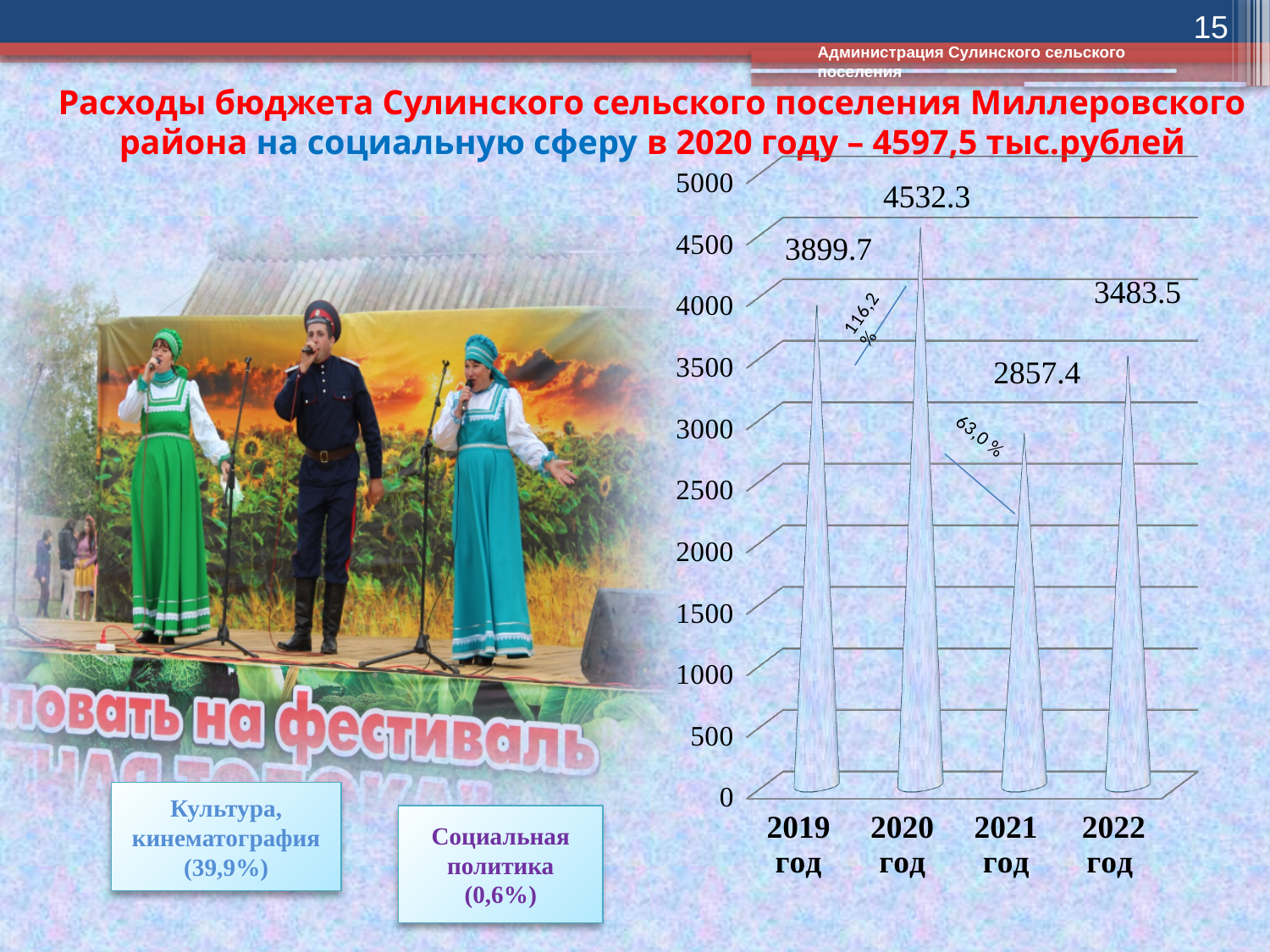
How many years are shown on the x axis of the chart? 4 Which year has the lowest value on the chart? 2021 год What is the value shown for 2022 год? 3483.5 What is the value shown for 2019 год? 3899.7 What kind of chart is shown on the slide? bar chart What is the value shown for 2020 год? 4532.3 What is the value shown for 2021 год? 2857.4 Which is larger, the value for 2022 год or the value for 2021 год? 2022 год Which year has the highest value on the chart? 2020 год What is the difference between the values for 2020 год and 2019 год? 632.6 Does the value rise or fall from 2020 год to 2021 год? fall What is the difference between the values for 2019 год and 2021 год? 1042.3